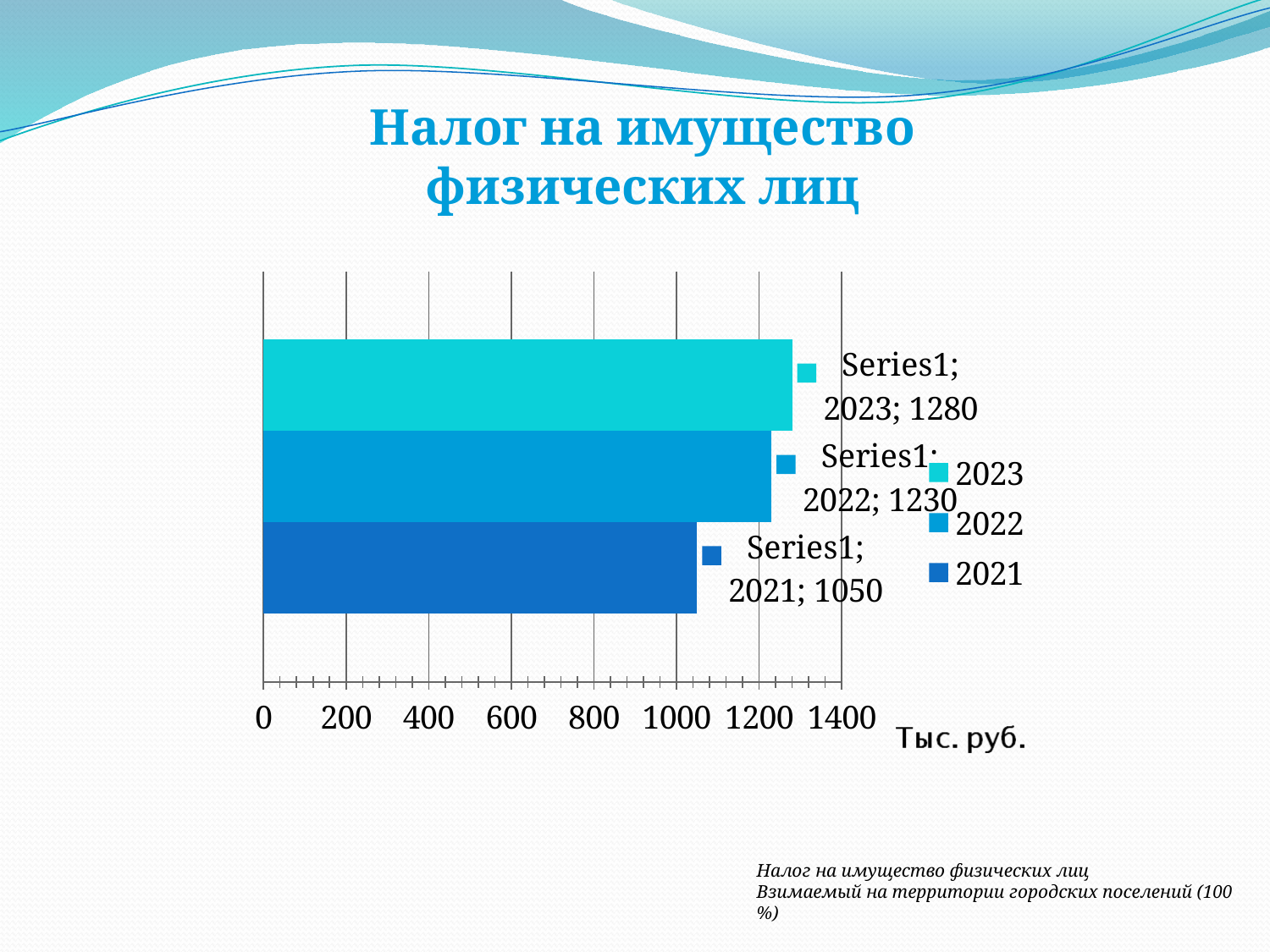
What is the difference between the values for 2023 and 2021? 230 Which is larger, the value for 2022 or the value for 2021? 2022 What is the value for 2023? 1280 Is the value for 2021 greater or less than 1000? greater What is the value for 2022? 1230 What kind of chart is shown on the slide? bar chart Which year has the lowest value? 2021 What is the difference between the values for 2022 and 2021? 180 How many bars are shown in the chart? 3 What unit is shown on the horizontal axis of the chart? Тыс. руб. Which year has the highest value? 2023 What is the value for 2021? 1050